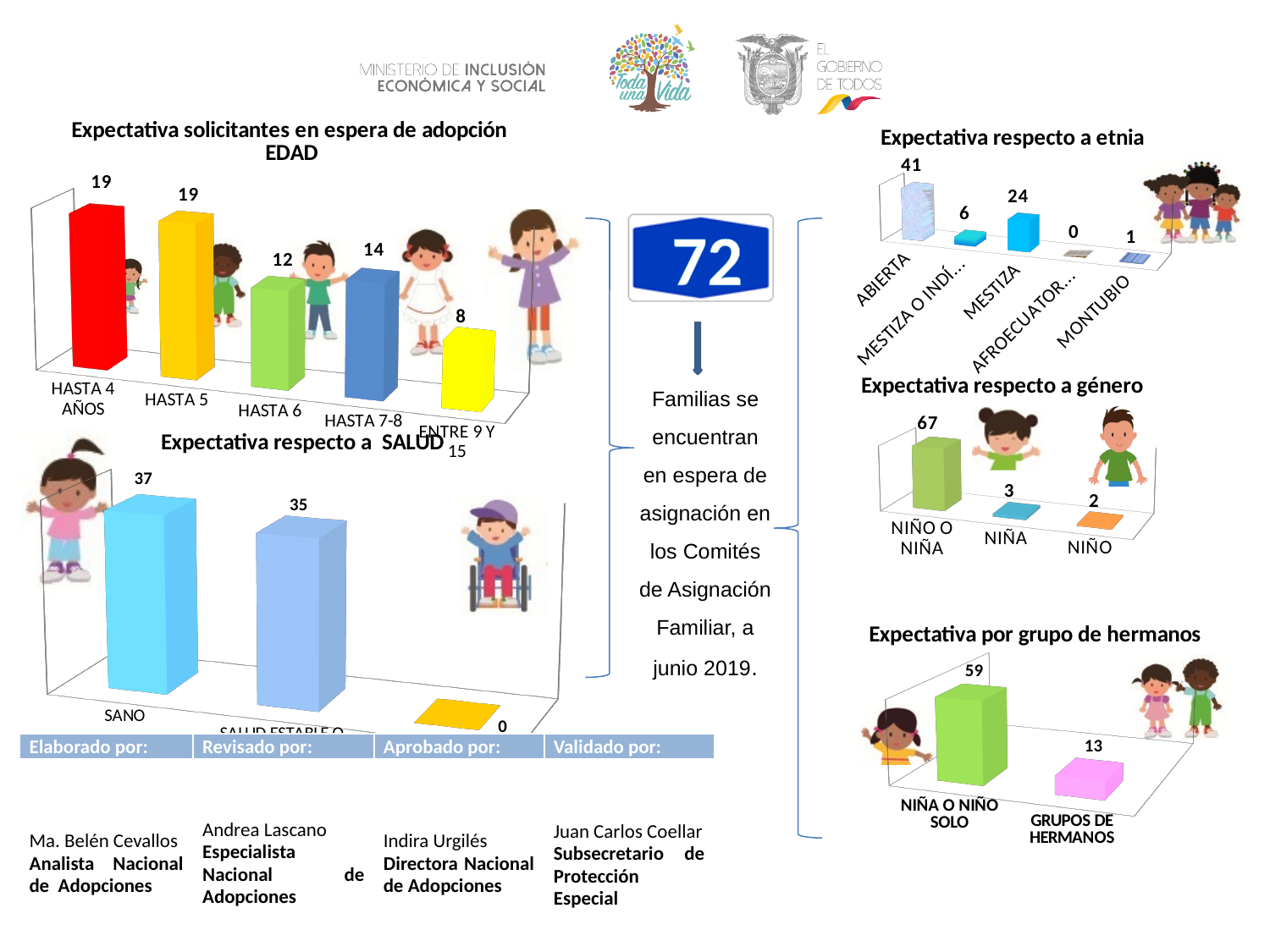
In the 'Expectativa solicitantes en espera de adopción EDAD' chart, what is the value for HASTA 6? 12 In the 'Expectativa respecto a etnia' chart, what is the value for MESTIZA? 24 In the 'Expectativa solicitantes en espera de adopción EDAD' chart, what is the difference between the values for HASTA 7-8 and ENTRE 9 Y 15? 6 In the 'Expectativa respecto a etnia' chart, what is the value for MONTUBIO? 1 In the 'Expectativa solicitantes en espera de adopción EDAD' chart, which category has the lowest value? ENTRE 9 Y 15 In the 'Expectativa respecto a SALUD' chart, what is the value for SANO? 37 In the 'Expectativa respecto a etnia' chart, which category has the highest value? ABIERTA In the 'Expectativa por grupo de hermanos' chart, what is the difference between the values for NIÑA O NIÑO SOLO and GRUPOS DE HERMANOS? 46 In the 'Expectativa solicitantes en espera de adopción EDAD' chart, how many categories are shown? 5 In the 'Expectativa respecto a género' chart, which is larger, the value for NIÑA or the value for NIÑO? NIÑA In the 'Expectativa respecto a género' chart, what is the value for NIÑO O NIÑA? 67 What kind of chart is 'Expectativa por grupo de hermanos'? Bar chart